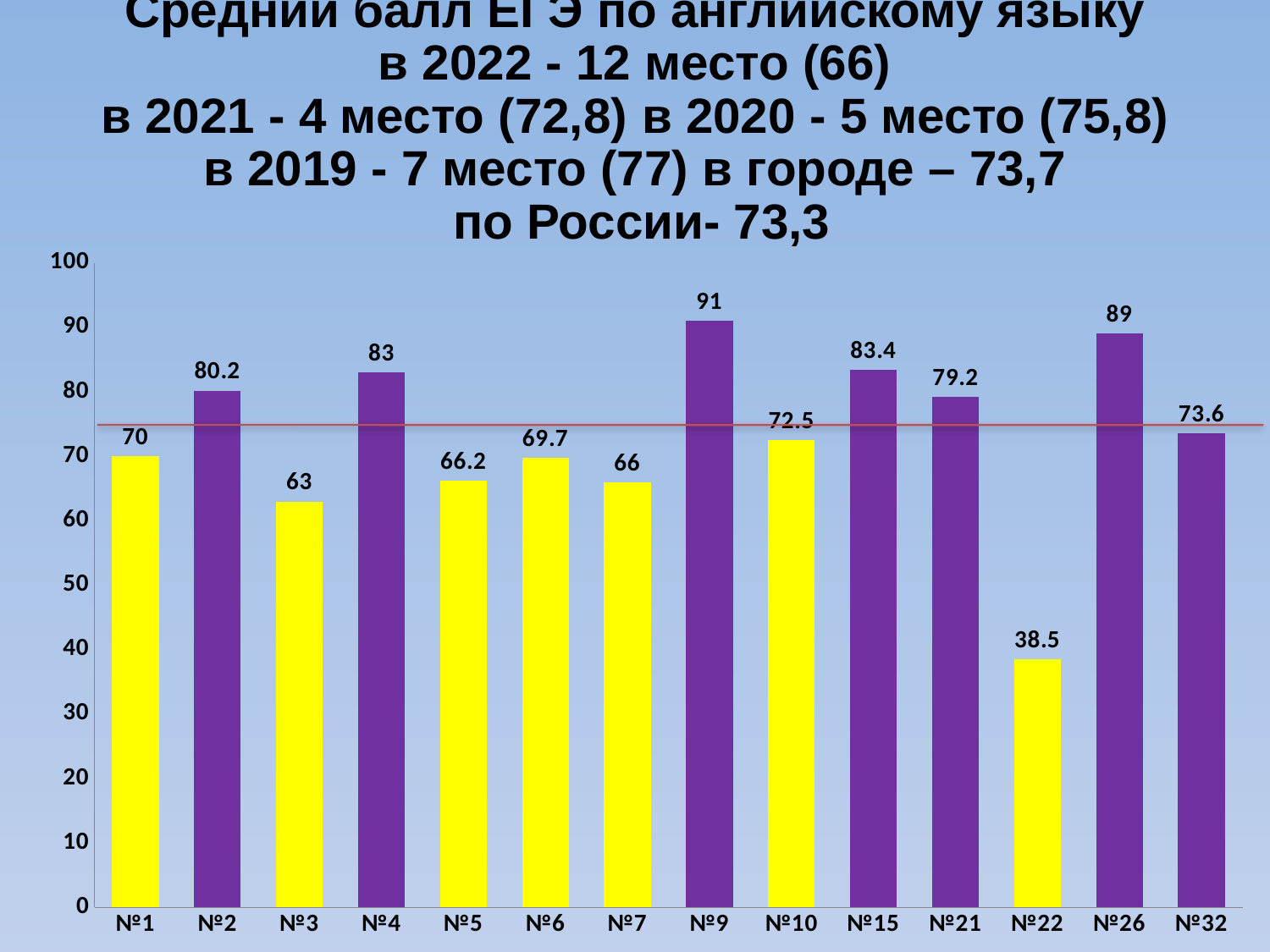
How many categories are shown on the x axis? 14 What is the value for №22? 38.5 What is the difference between the values for №26 and №2? 8.8 Which is larger, the value for №4 or the value for №21? №4 Which category has the lowest value? №22 What is the value for №9? 91 What kind of chart is shown on the slide? bar chart What is the value for №32? 73.6 Which category has the highest value? №9 What colour is the bar for №22? yellow Is the value for №10 greater or less than 80? less What is the value for №15? 83.4